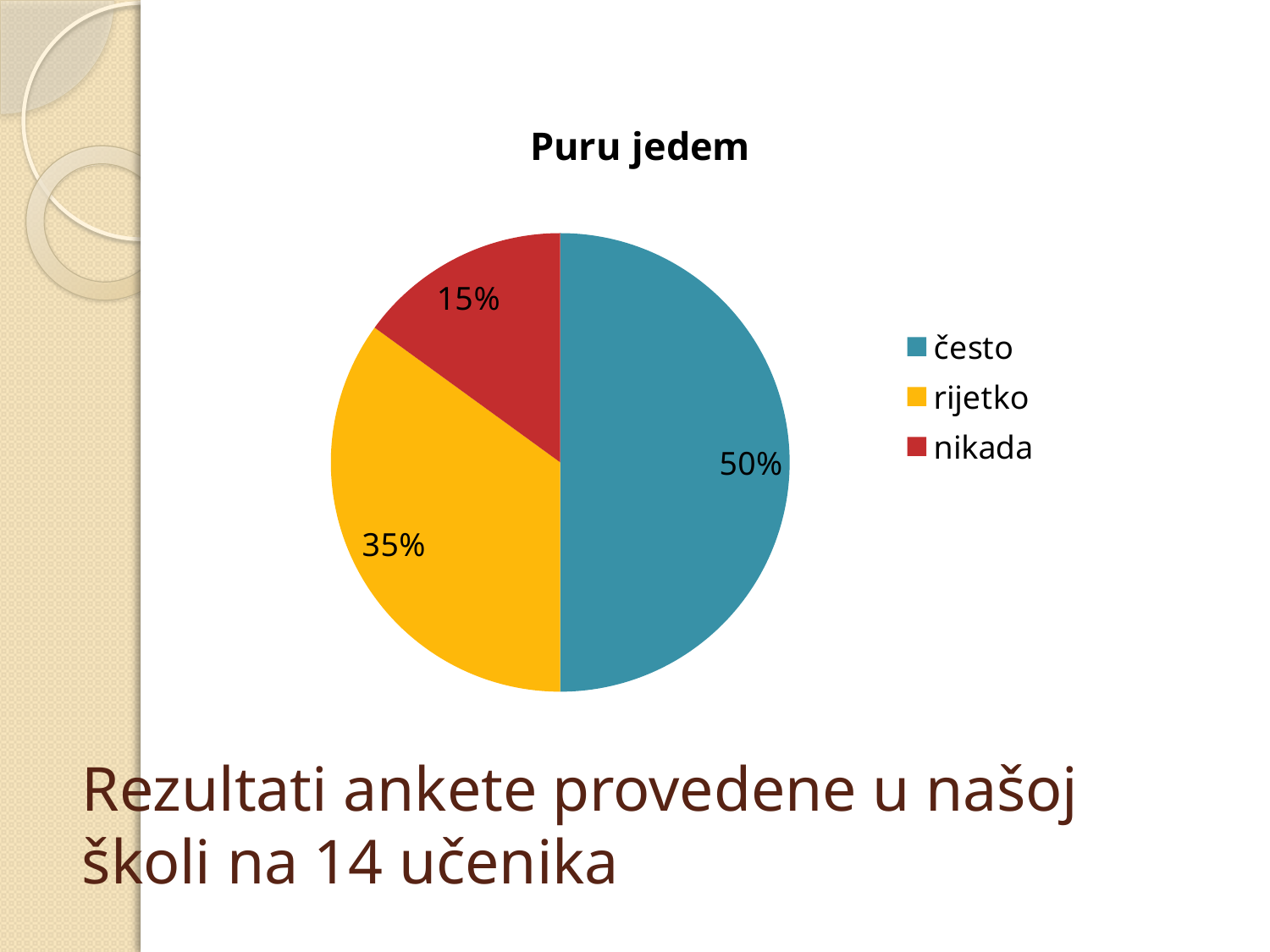
What is the difference in percentage points between the "često" and "nikada" slices? 35 What kind of chart is shown on the slide? pie chart Which slice is larger, "rijetko" or "nikada"? rijetko How many entries does the legend list? 3 What percentage is shown for the "rijetko" slice? 35% Which category has the largest slice of the pie? često What colour is the "rijetko" slice? yellow What percentage is shown for the "često" slice? 50% How many slices does the pie chart have? 3 What is the title of the chart? Puru jedem Which category has the smallest slice of the pie? nikada What percentage is shown for the "nikada" slice? 15%